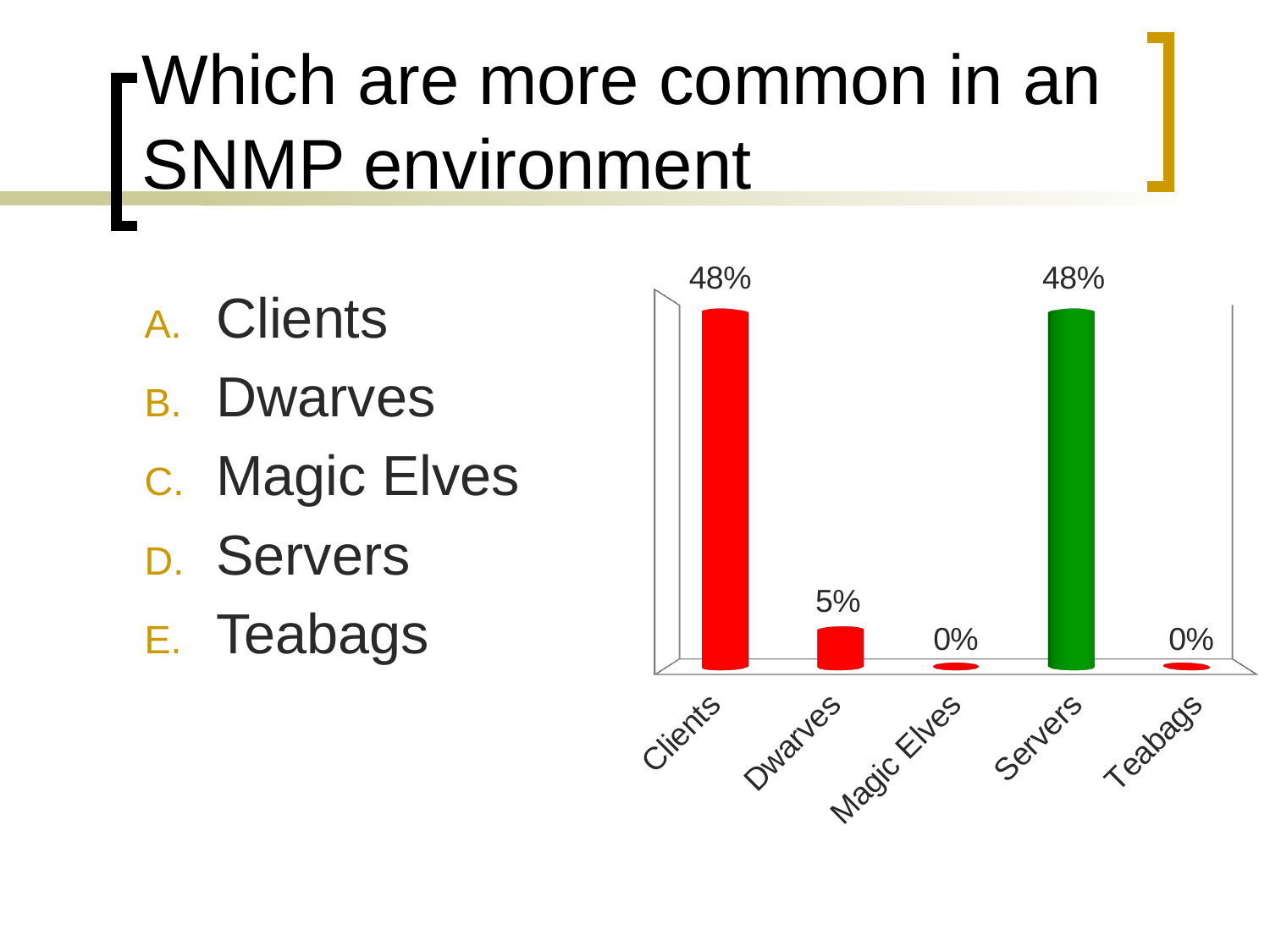
What kind of chart is shown on the slide? Bar chart Which two categories share the highest value in the chart? Clients and Servers Which two categories share the lowest value in the chart? Magic Elves and Teabags What value is shown for Magic Elves? 0% What value is shown for Dwarves? 5% Which category's bar is coloured green? Servers How many categories are shown on the x axis of the chart? 5 What is the difference between the values for Clients and Dwarves? 43% Which has a larger value, Dwarves or Servers? Servers What value is shown for Servers? 48% What value is shown for Clients? 48% What value is shown for Teabags? 0%